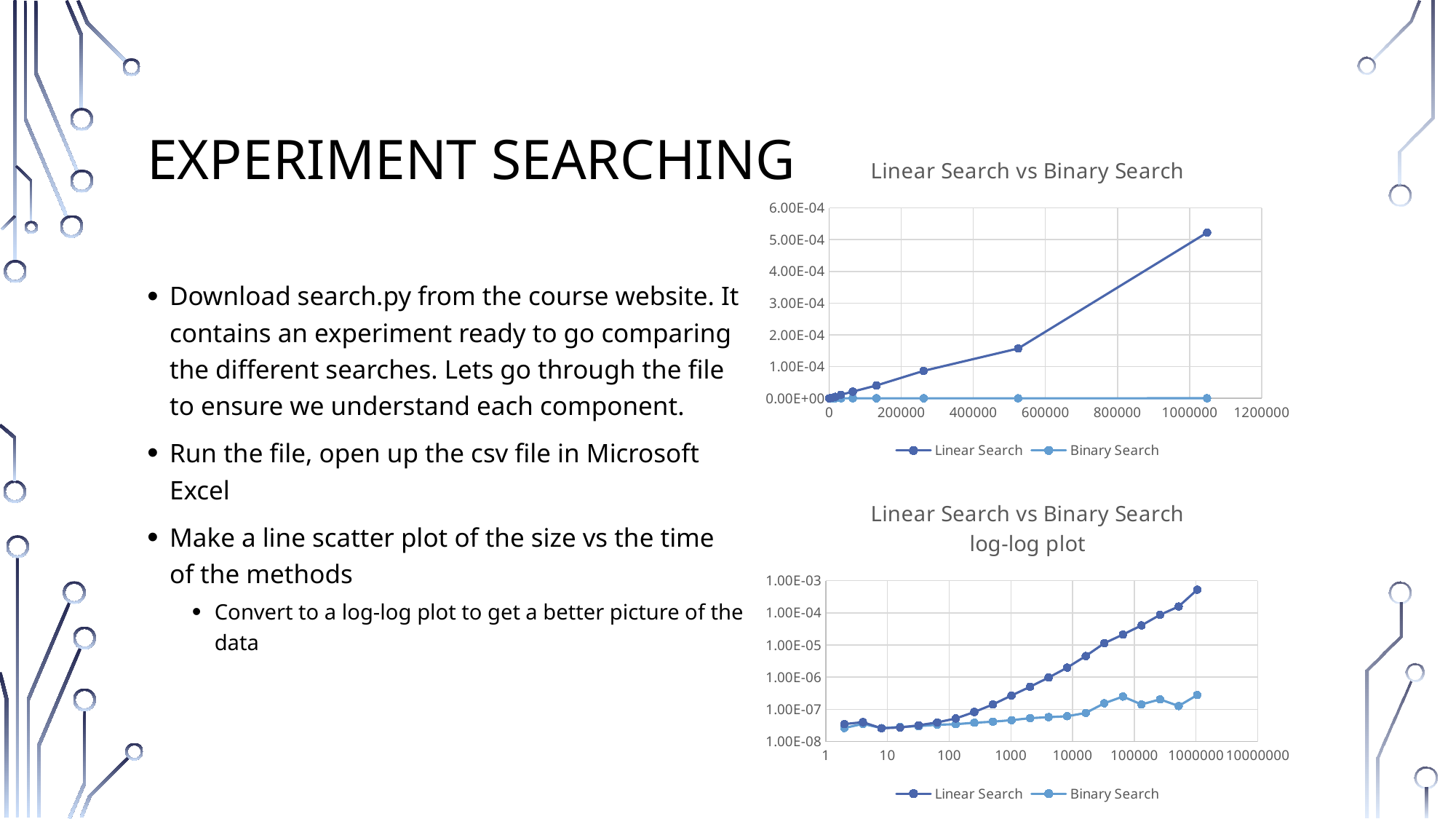
In the top chart 'Linear Search vs Binary Search', does the Linear Search series rise or fall as the input size increases? rise How many series does the legend of the bottom chart 'Linear Search vs Binary Search log-log plot' list? 2 How many series does the legend of the top chart 'Linear Search vs Binary Search' list? 2 In the top chart 'Linear Search vs Binary Search', is the Linear Search value at the largest input size (around 1000000) greater or less than 4.00E-04? greater In the top chart 'Linear Search vs Binary Search', which series has the higher value at the largest input size? Linear Search What is the title of the bottom chart? Linear Search vs Binary Search log-log plot In the top chart 'Linear Search vs Binary Search', is the Binary Search value at the largest input size greater or less than 1.00E-04? less In the bottom chart 'Linear Search vs Binary Search log-log plot', which series is higher at 100000? Linear Search In the top chart 'Linear Search vs Binary Search', is the Linear Search value at roughly 500000 greater or less than 1.00E-04? greater What type of chart is the top chart titled 'Linear Search vs Binary Search'? line chart